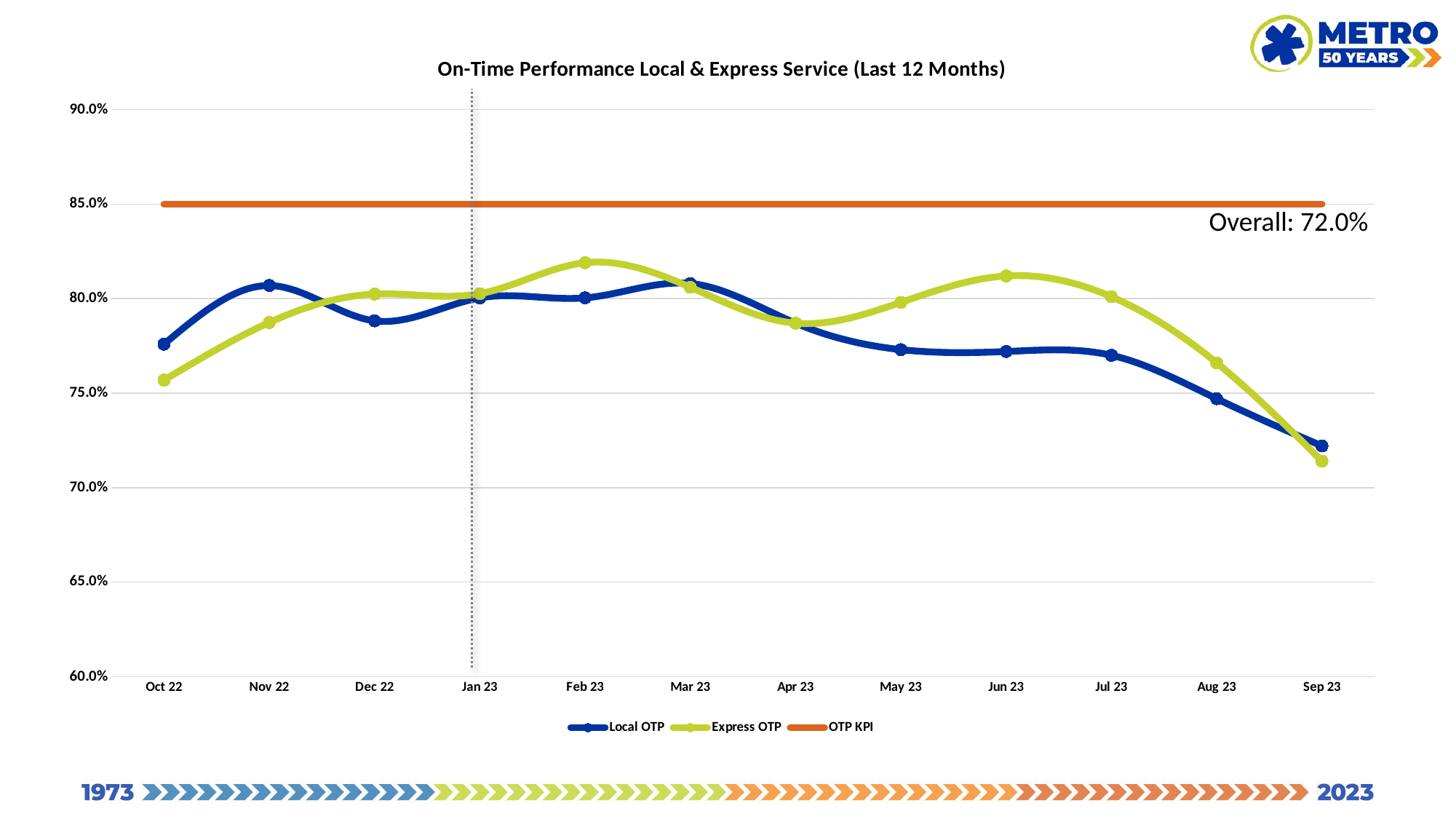
What overall value is annotated on the chart? Overall: 72.0% What is the value of the OTP KPI line? 85.0% What is the title of the chart? On-Time Performance Local & Express Service (Last 12 Months) Does Express OTP rise or fall from Jun 23 to Sep 23? fall What kind of chart is shown on the slide? line chart How many series does the legend list? 3 Is the Local OTP value for Sep 23 greater or less than 75.0%? less Is the Express OTP value for Feb 23 greater or less than 80.0%? greater How many months are plotted along the x axis? 12 Is the Express OTP value for Oct 22 greater or less than 80.0%? less In Oct 22, which is higher, Local OTP or Express OTP? Local OTP In which month is Express OTP lowest? Sep 23